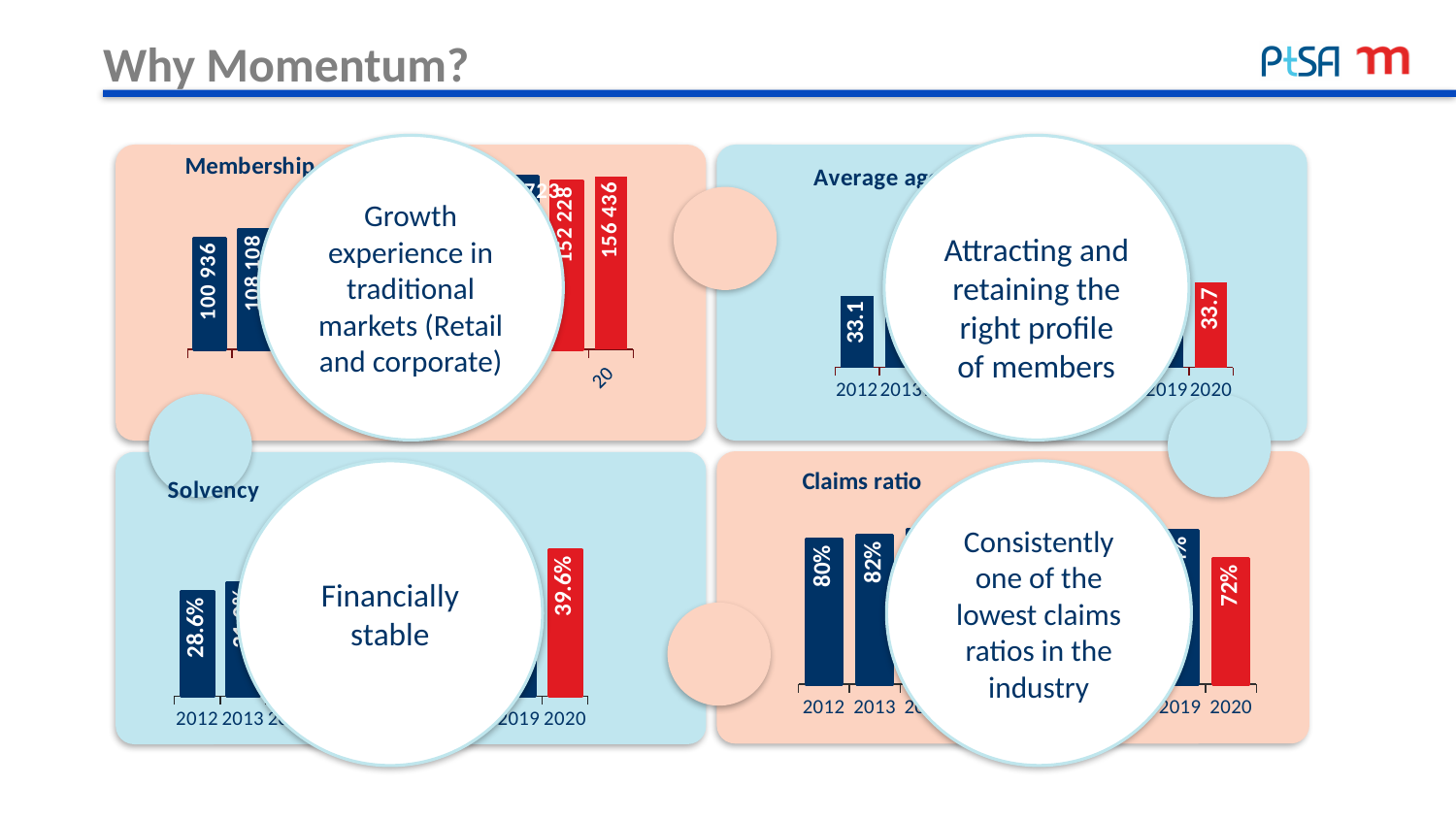
In the Solvency chart, what is the solvency value for 2020? 39.6% In the Solvency chart, what is the solvency value for 2012? 28.6% In the Average age chart, what is the average age for 2020? 33.7 In the Claims ratio chart, what is the claims ratio for 2012? 80% In the Claims ratio chart, what is the claims ratio for 2013? 82% What type of chart is the Solvency chart? Bar chart In the Membership chart, what is the value of the rightmost (last) bar? 156 436 In the Membership chart, what is the difference between the last bar (156 436) and the second-to-last bar (152 228)? 4 208 In the Claims ratio chart, what is the claims ratio for 2020? 72% In the Average age chart, what is the average age for 2012? 33.1 In the Claims ratio chart, which is larger, the value for 2012 or the value for 2020? 2012 In the Solvency chart, by how many percentage points does the 2020 value exceed the 2012 value? 11.0 percentage points